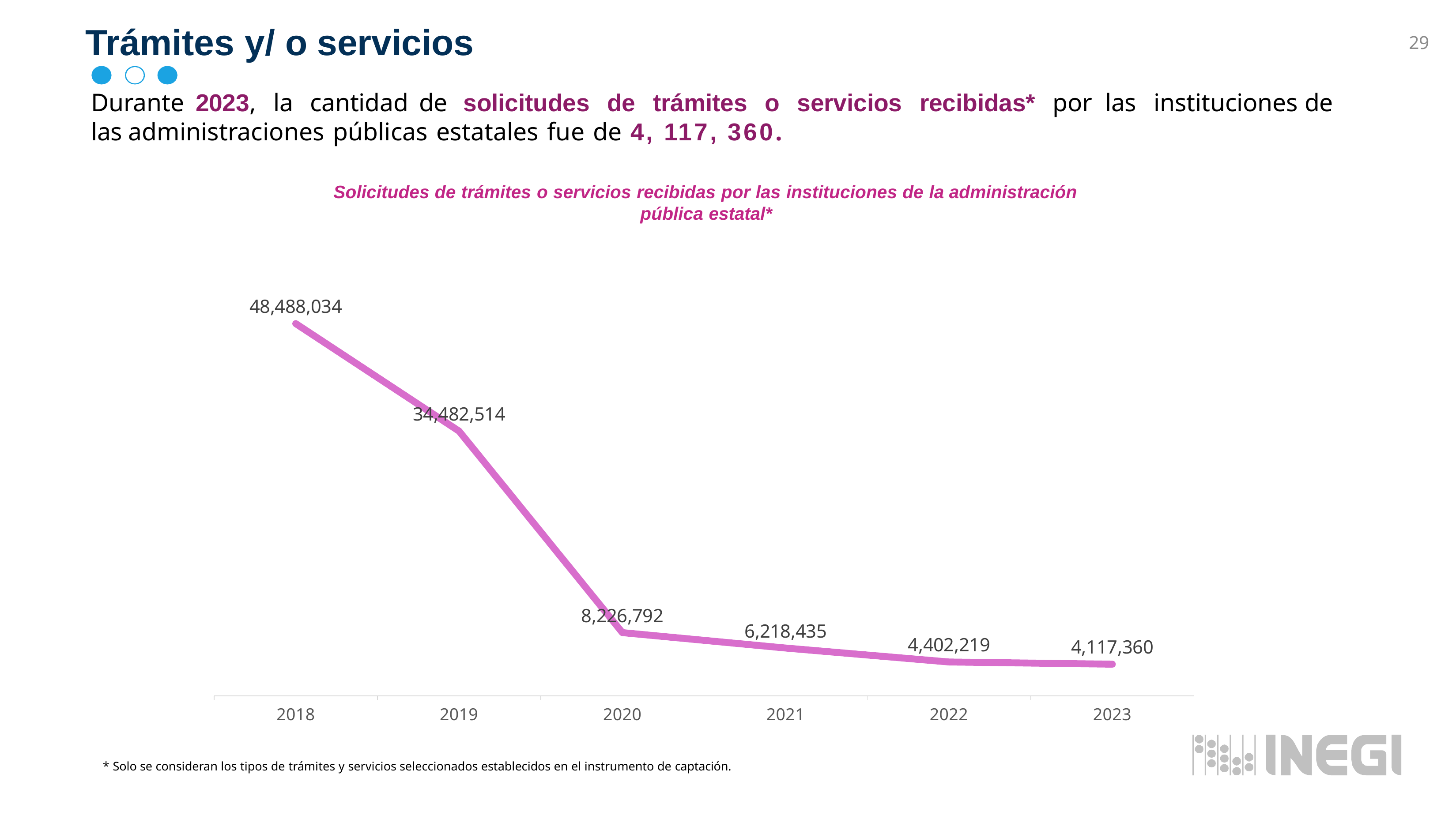
What kind of chart is shown? Line chart Which year has the lowest value? 2023 What is the value for 2018? 48,488,034 What is the value for 2020? 8,226,792 What is the difference between the values for 2022 and 2023? 284,859 Which is larger, the value for 2019 or the value for 2020? 2019 What is the value for 2021? 6,218,435 Do the values rise or fall from 2018 to 2023? Fall Which year has the highest value? 2018 How many years are plotted on the chart? 6 What is the difference between the values for 2018 and 2019? 14,005,520 What is the value for 2023? 4,117,360